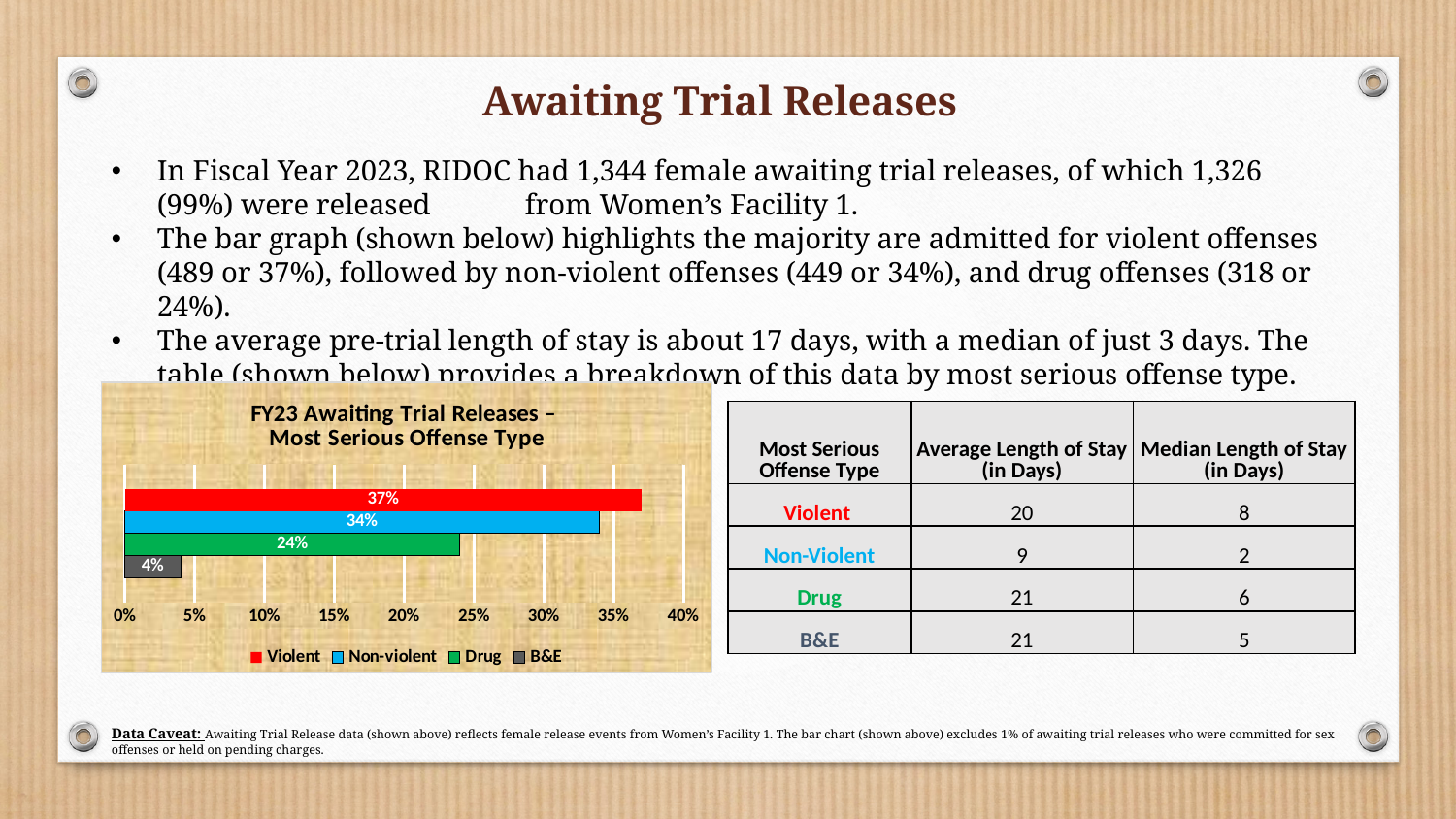
Which offense type has the highest percentage in the FY23 Awaiting Trial Releases chart? Violent Which offense type has the lowest percentage in the FY23 Awaiting Trial Releases chart? B&E What kind of chart is the FY23 Awaiting Trial Releases – Most Serious Offense Type chart? Bar chart How many entries does the legend of the FY23 Awaiting Trial Releases chart list? 4 In the FY23 Awaiting Trial Releases chart, which is larger, the Non-violent bar or the Drug bar? Non-violent Is the value for Drug in the FY23 Awaiting Trial Releases chart greater or less than 20%? greater What percentage does the Violent bar show in the FY23 Awaiting Trial Releases chart? 37% What is the difference in percentage points between the Violent and Drug bars in the FY23 Awaiting Trial Releases chart? 13 What percentage does the B&E bar show in the FY23 Awaiting Trial Releases chart? 4% What percentage does the Drug bar show in the FY23 Awaiting Trial Releases chart? 24% What percentage does the Non-violent bar show in the FY23 Awaiting Trial Releases chart? 34% How many offense types are plotted in the FY23 Awaiting Trial Releases chart? 4